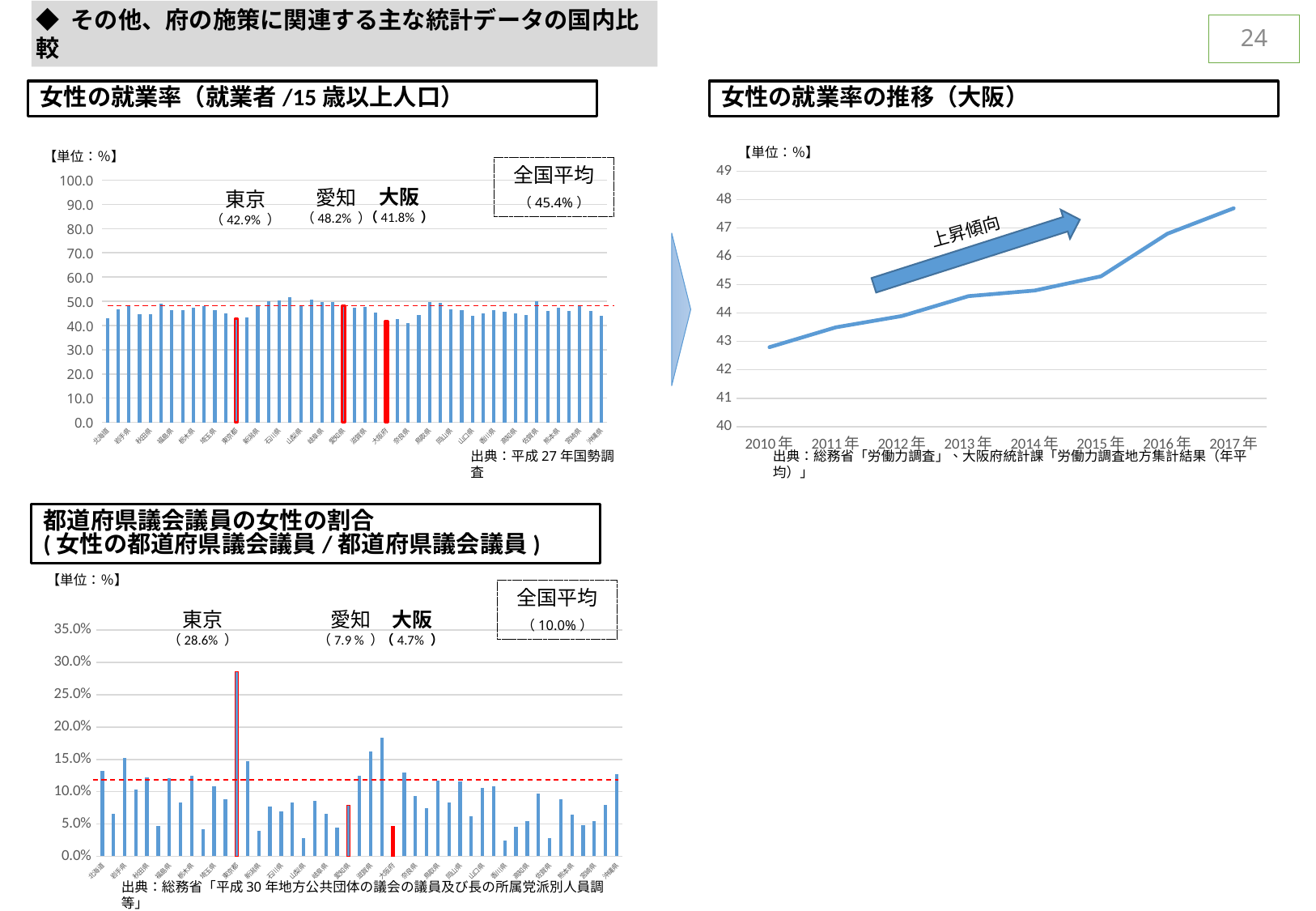
In the chart titled 女性の就業率（就業者/15歳以上人口）, what is the difference between the printed values for 愛知 and 大阪? 6.4 In the chart titled 都道府県議会議員の女性の割合, what is the value printed for 東京? 28.6% In the chart titled 女性の就業率（就業者/15歳以上人口）, which has the larger printed value, 東京 or 愛知? 愛知 What kind of chart is the one titled 女性の就業率の推移（大阪）? line chart In the chart titled 都道府県議会議員の女性の割合, which prefecture has the highest bar? 東京 In the chart titled 女性の就業率（就業者/15歳以上人口）, what is the 全国平均 value shown? 45.4% In the chart titled 女性の就業率（就業者/15歳以上人口）, what is the value printed for 大阪? 41.8% In the chart titled 女性の就業率の推移（大阪）, do the values rise or fall from 2010年 to 2017年? rise In the chart titled 女性の就業率の推移（大阪）, is the value for 2017年 greater or less than 47? greater How many years are plotted in the chart titled 女性の就業率の推移（大阪）? 8 In the chart titled 女性の就業率（就業者/15歳以上人口）, what is the value printed for 東京? 42.9% In the chart titled 女性の就業率の推移（大阪）, is the value for 2010年 greater or less than 43? less